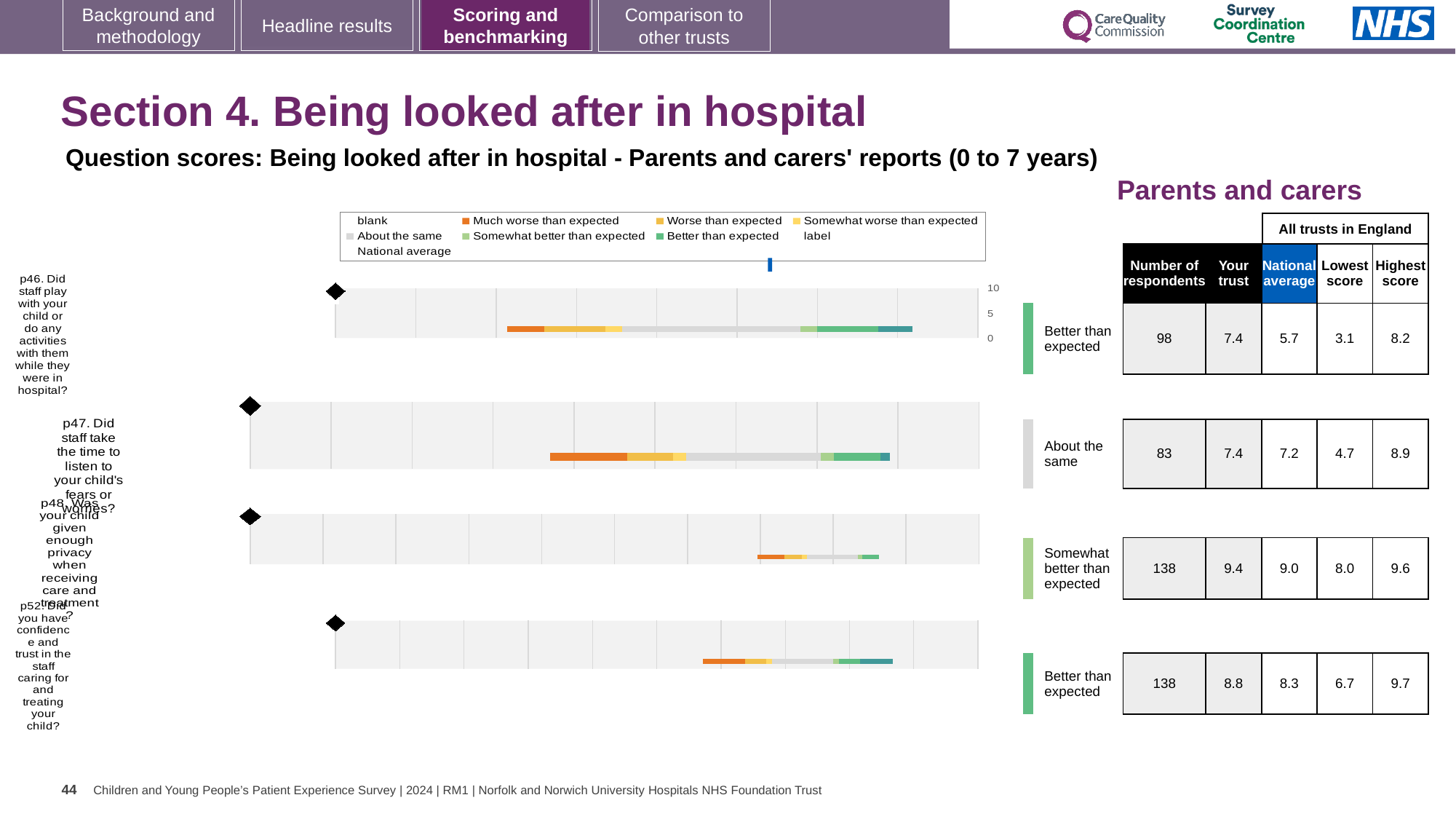
What is the highest score across all trusts in England for p52 (Did you have confidence and trust in the staff caring for and treating your child?)? 9.7 For p46, which is larger: the 'Your trust' score or the national average? Your trust What kind of chart is used to show the question scores on this slide? bar chart Which question has the lowest national average score? p46 How many survey questions are plotted in the chart? 4 Which benchmark category is p46 placed in? Better than expected Which question has the highest 'Your trust' score? p48 How many respondents answered p48 (Was your child given enough privacy when receiving care and treatment?)? 138 What is the national average score for p47 (Did staff take the time to listen to your child's fears or worries?)? 7.2 What is the 'Your trust' score for p46 (Did staff play with your child or do any activities with them while they were in hospital?)? 7.4 Which benchmark category is p48 placed in? Somewhat better than expected What is the difference between the 'Your trust' score and the national average for p52? 0.5